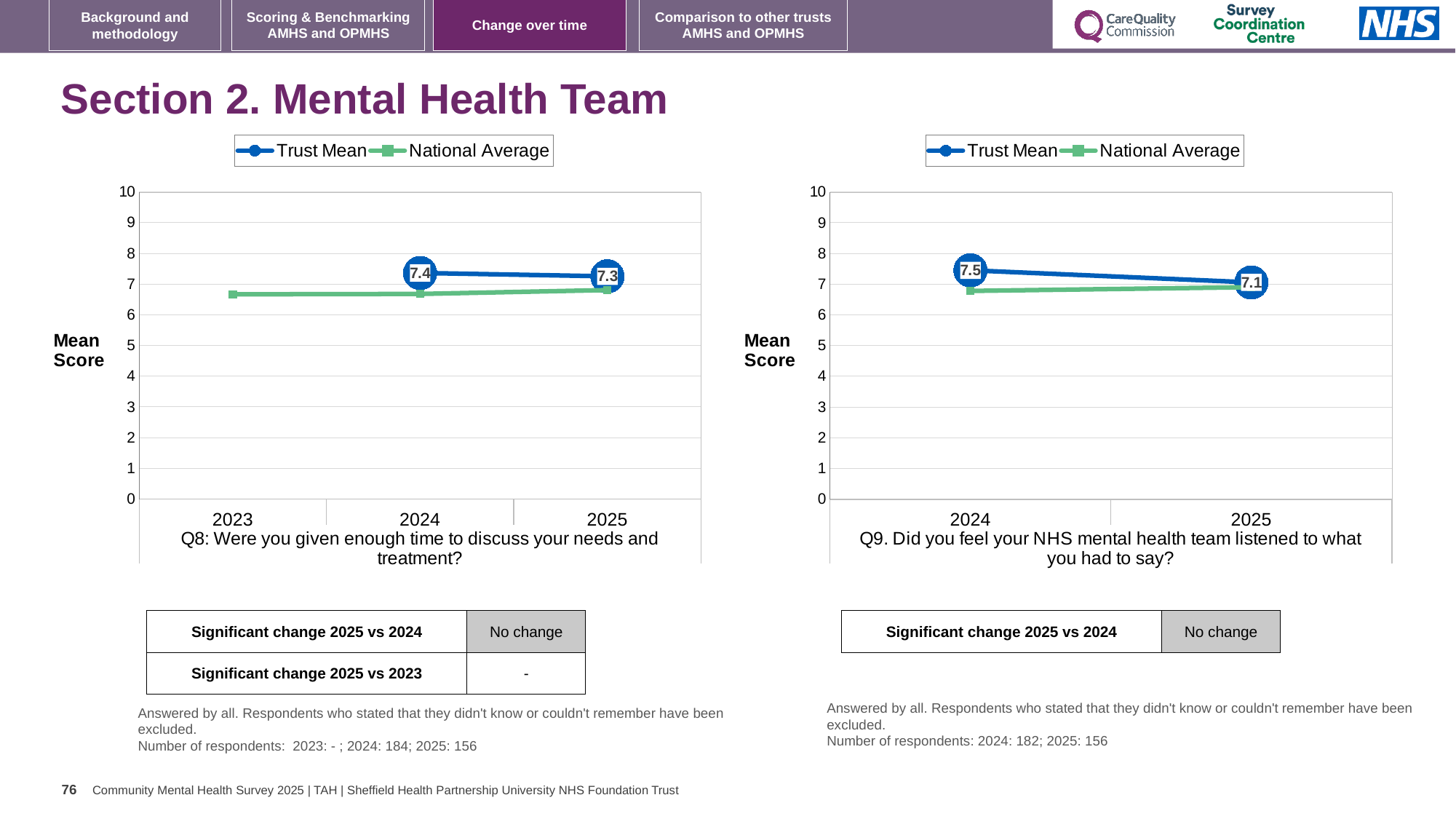
In the left chart (Q8), is the National Average for 2023 greater or less than 7? less In the left chart (Q8), does the Trust Mean rise or fall from 2024 to 2025? fall What is the label of the y axis on the left chart (Q8)? Mean Score In the right chart (Q9), what is the Trust Mean for 2025? 7.1 In the right chart (Q9), is the Trust Mean for 2024 higher or lower than the National Average for 2024? higher In the right chart (Q9), by how much did the Trust Mean fall from 2024 to 2025? 0.4 In the right chart (Q9), what is the Trust Mean for 2024? 7.5 How many years are shown on the x axis of the left chart (Q8)? 3 What type of chart is used for Q9 on the right? line chart How many series does the legend of the right chart (Q9) list? 2 In the left chart (Q8), what is the Trust Mean for 2024? 7.4 In the left chart (Q8), what is the Trust Mean for 2025? 7.3